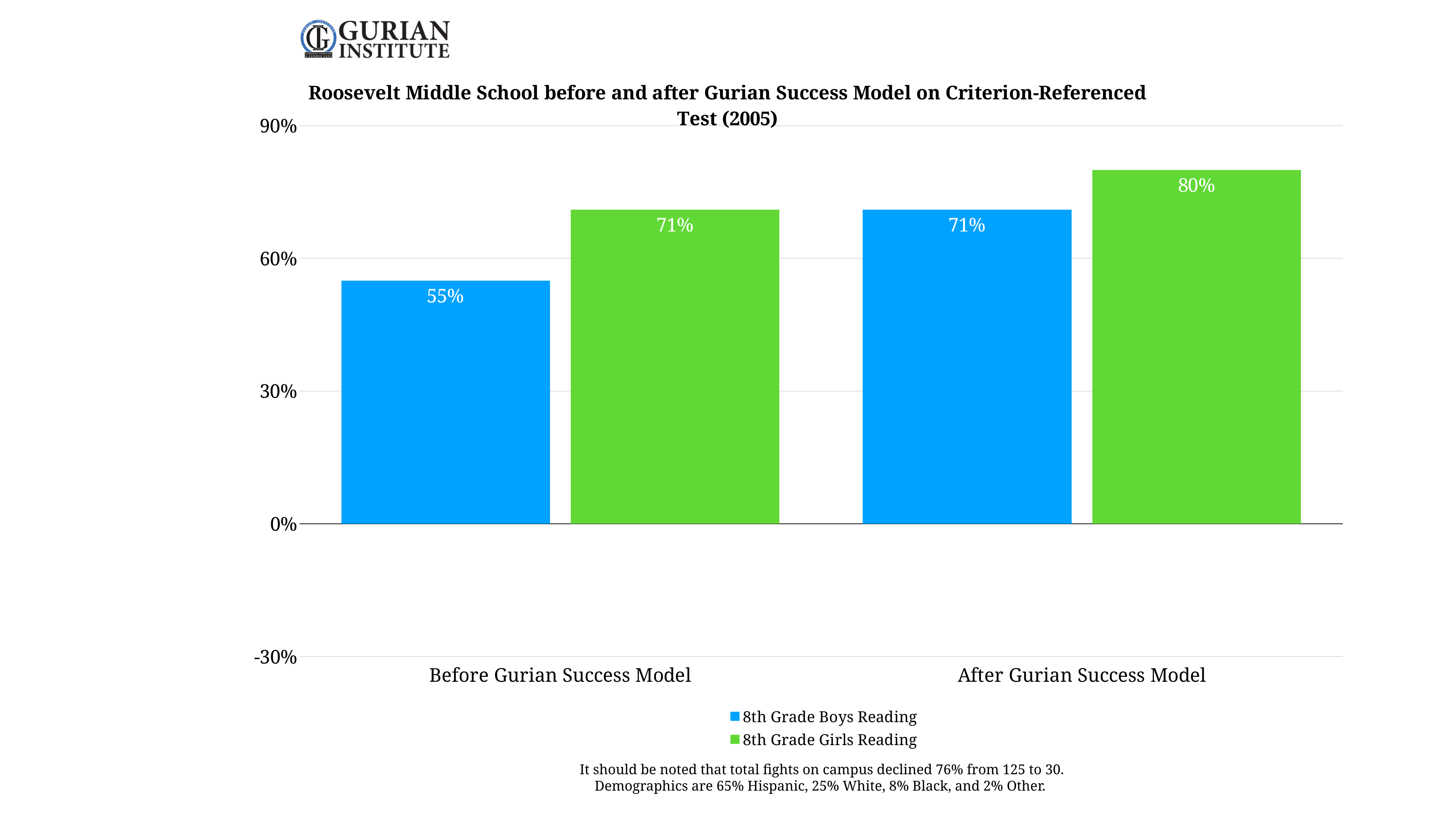
What is the value for 8th Grade Boys Reading before the Gurian Success Model? 55% Which is larger: 8th Grade Boys Reading before the Gurian Success Model or 8th Grade Girls Reading before the Gurian Success Model? 8th Grade Girls Reading Which bar has the highest value on the chart? 8th Grade Girls Reading, After Gurian Success Model What is the value for 8th Grade Girls Reading after the Gurian Success Model? 80% What is the difference between 8th Grade Boys Reading before and after the Gurian Success Model? 16% What kind of chart is shown on the slide? Bar chart What is the value for 8th Grade Boys Reading after the Gurian Success Model? 71% Which colour represents 8th Grade Girls Reading in the chart? Green Which bar has the lowest value on the chart? 8th Grade Boys Reading, Before Gurian Success Model What is the value for 8th Grade Girls Reading before the Gurian Success Model? 71% What is the difference between 8th Grade Girls Reading before and after the Gurian Success Model? 9% How many series does the legend list? 2